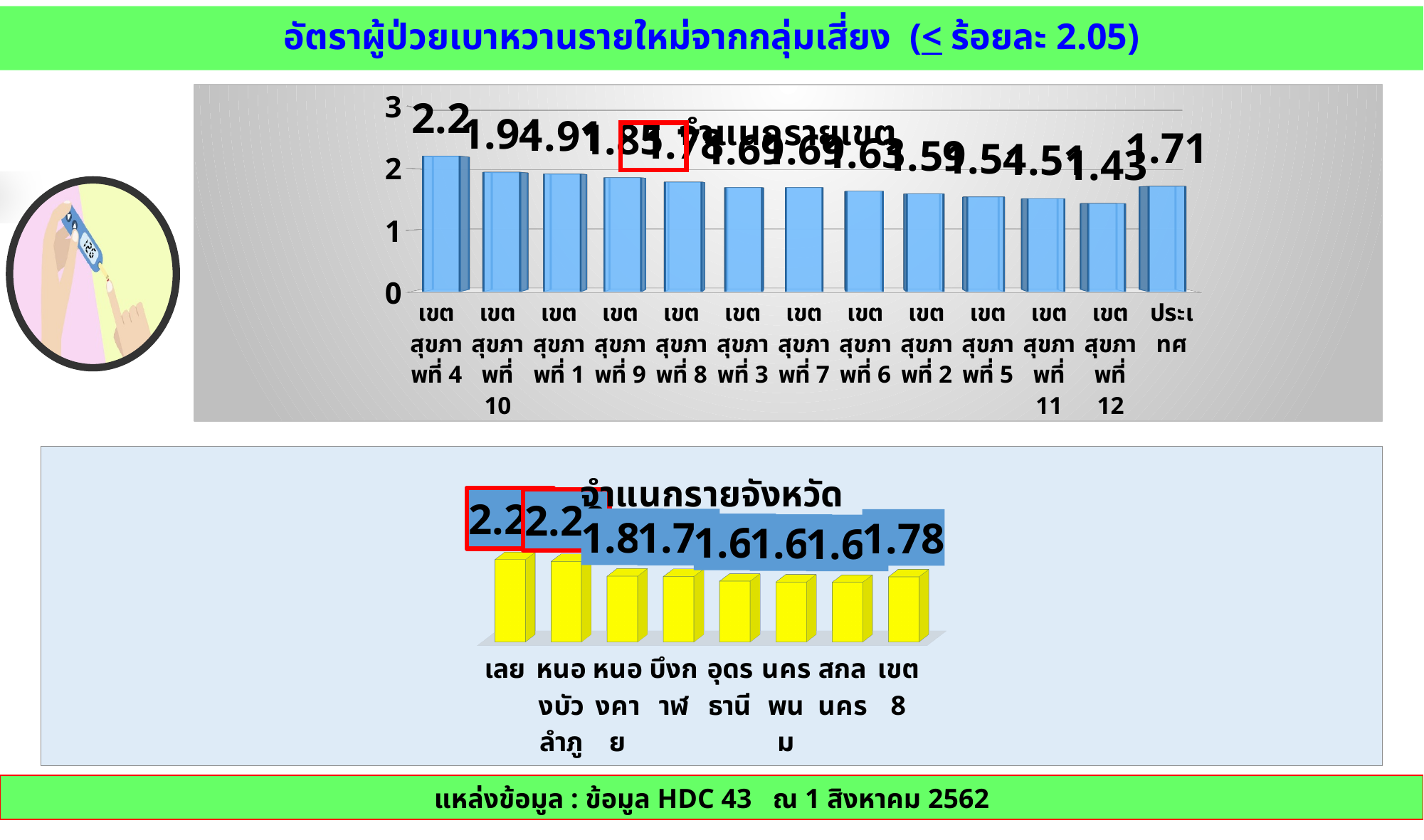
In the top chart (จำแนกรายเขต), what is the value for ประเทศ? 1.71 In the bottom chart (จำแนกรายจังหวัด), how many categories are plotted? 8 In the top chart (จำแนกรายเขต), which is larger: the value for เขตสุขภาพที่ 4 or the value for ประเทศ? เขตสุขภาพที่ 4 In the top chart (จำแนกรายเขต), is the value for เขตสุขภาพที่ 4 greater or less than 2? greater In the bottom chart (จำแนกรายจังหวัด), what is the value for เขต 8? 1.78 In the top chart (จำแนกรายเขต), which category has the lowest value? เขตสุขภาพที่ 12 What kind of chart is the top chart titled จำแนกรายเขต? bar chart In the top chart (จำแนกรายเขต), what is the value for เขตสุขภาพที่ 10? 1.94 In the top chart (จำแนกรายเขต), which category has the highest value? เขตสุขภาพที่ 4 In the top chart (จำแนกรายเขต), how many categories are plotted? 13 What kind of chart is the bottom chart titled จำแนกรายจังหวัด? bar chart